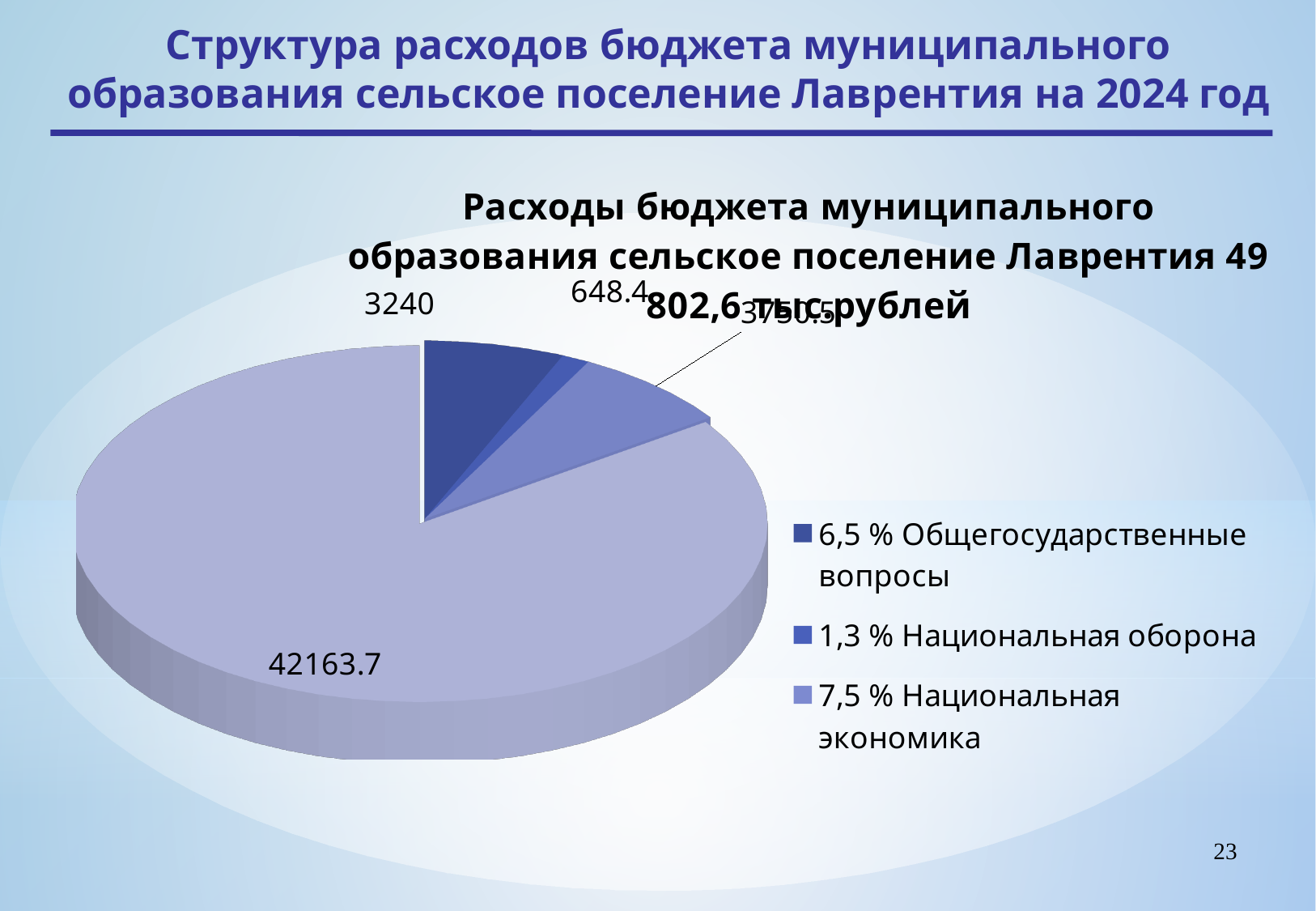
What percentage does the legend give for Общегосударственные вопросы? 6,5 % Which is larger, the value for Общегосударственные вопросы or the value for Национальная оборона? Общегосударственные вопросы What is the value shown for Национальная оборона? 648.4 What is the difference between the values for Общегосударственные вопросы and Национальная оборона? 2591.6 What kind of chart is shown on the slide? pie chart Which legend category has the smallest slice of the pie? Национальная оборона What is the value shown for Общегосударственные вопросы? 3240 What is the largest data label shown on the pie chart? 42163.7 What total amount in thousand rubles is stated in the chart title? 49 802,6 тыс.рублей How many slices does the pie chart have? 4 How many entries does the legend list? 3 What percentage does the legend give for Национальная экономика? 7,5 %